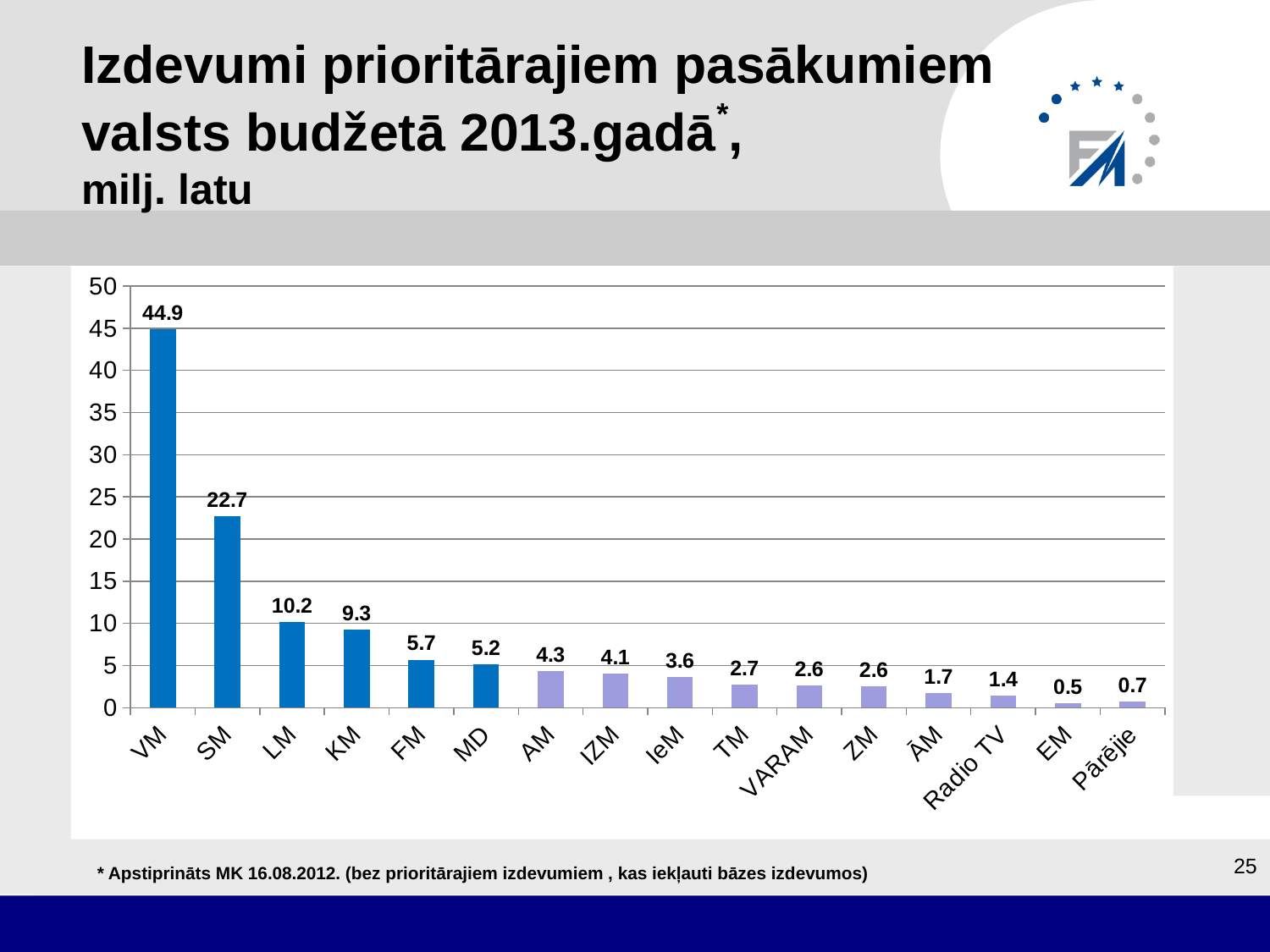
What is the difference between the values for VM and SM? 22.2 What is the value for IZM? 4.1 What is the value for Radio TV? 1.4 Which category has the highest value? VM What is the unit stated in the slide title for the chart values? milj. latu How many categories are shown on the x axis? 16 Which category has the lowest value? EM What is the value for VM? 44.9 Do the values generally rise or fall from left to right along the x axis? fall Which is larger, the value for LM or the value for KM? LM Is the value for SM greater or less than 20? greater What kind of chart is shown on the slide? bar chart